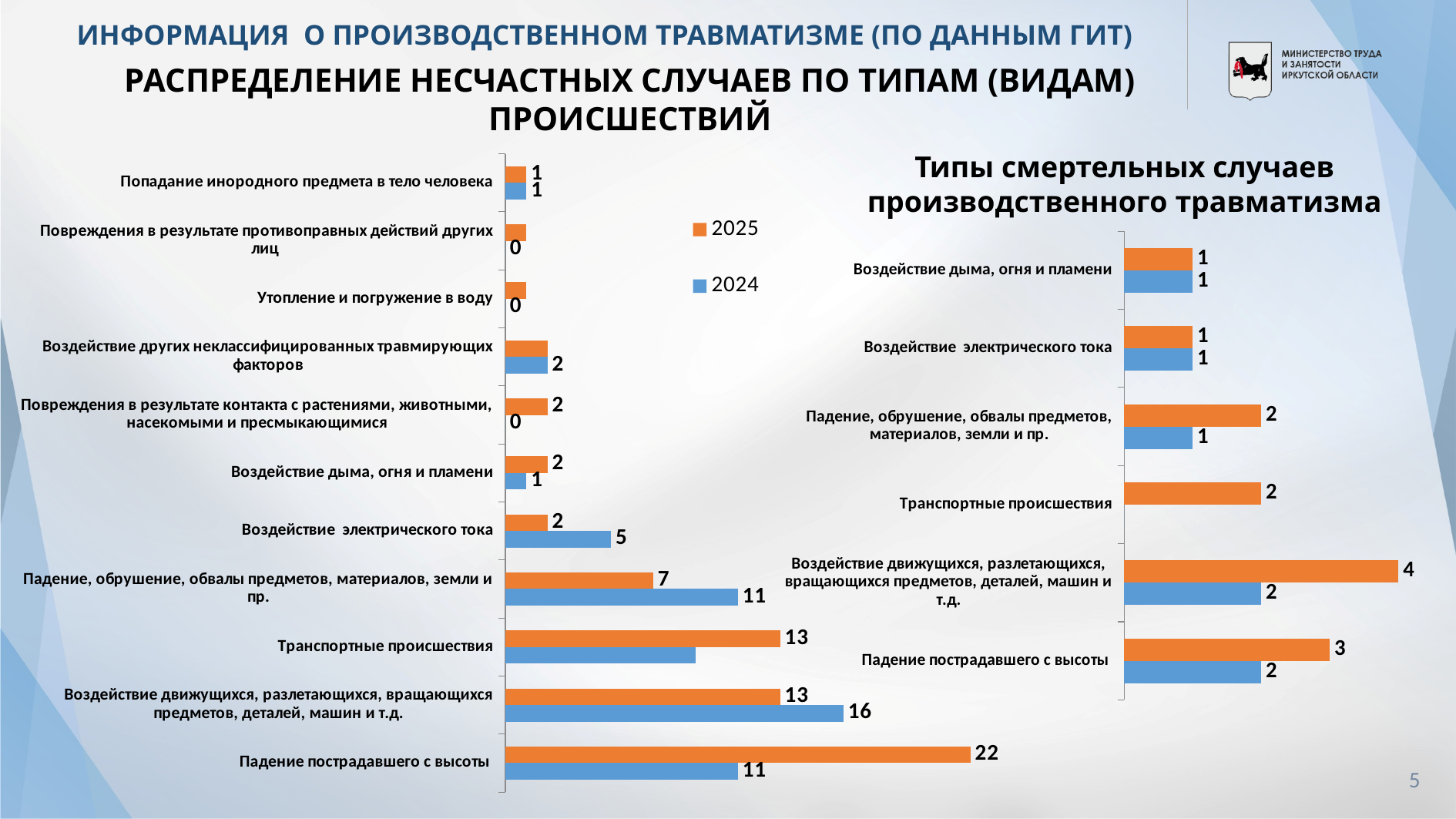
In the chart titled Типы смертельных случаев производственного травматизма, how many categories are shown? 6 In the left chart, how many categories are shown? 11 In the left chart, what is the difference between the 2025 and 2024 values for Падение пострадавшего с высоты? 11 In the chart titled Типы смертельных случаев производственного травматизма, what is the 2025 value for Воздействие движущихся, разлетающихся, вращающихся предметов, деталей, машин и т.д.? 4 How many series does the legend of the left chart list? 2 In the chart titled Типы смертельных случаев производственного травматизма, what is the difference between the 2025 and 2024 values for Падение пострадавшего с высоты? 1 In the left chart, which is larger for Воздействие электрического тока: the 2025 value or the 2024 value? 2024 In the left chart, which colour represents the 2025 series? Orange What type of chart is the chart titled Типы смертельных случаев производственного травматизма? Bar chart In the left chart, which category has the highest 2025 value? Падение пострадавшего с высоты In the left chart, what is the 2025 value for Падение пострадавшего с высоты? 22 In the left chart, what is the 2024 value for Воздействие движущихся, разлетающихся, вращающихся предметов, деталей, машин и т.д.? 16